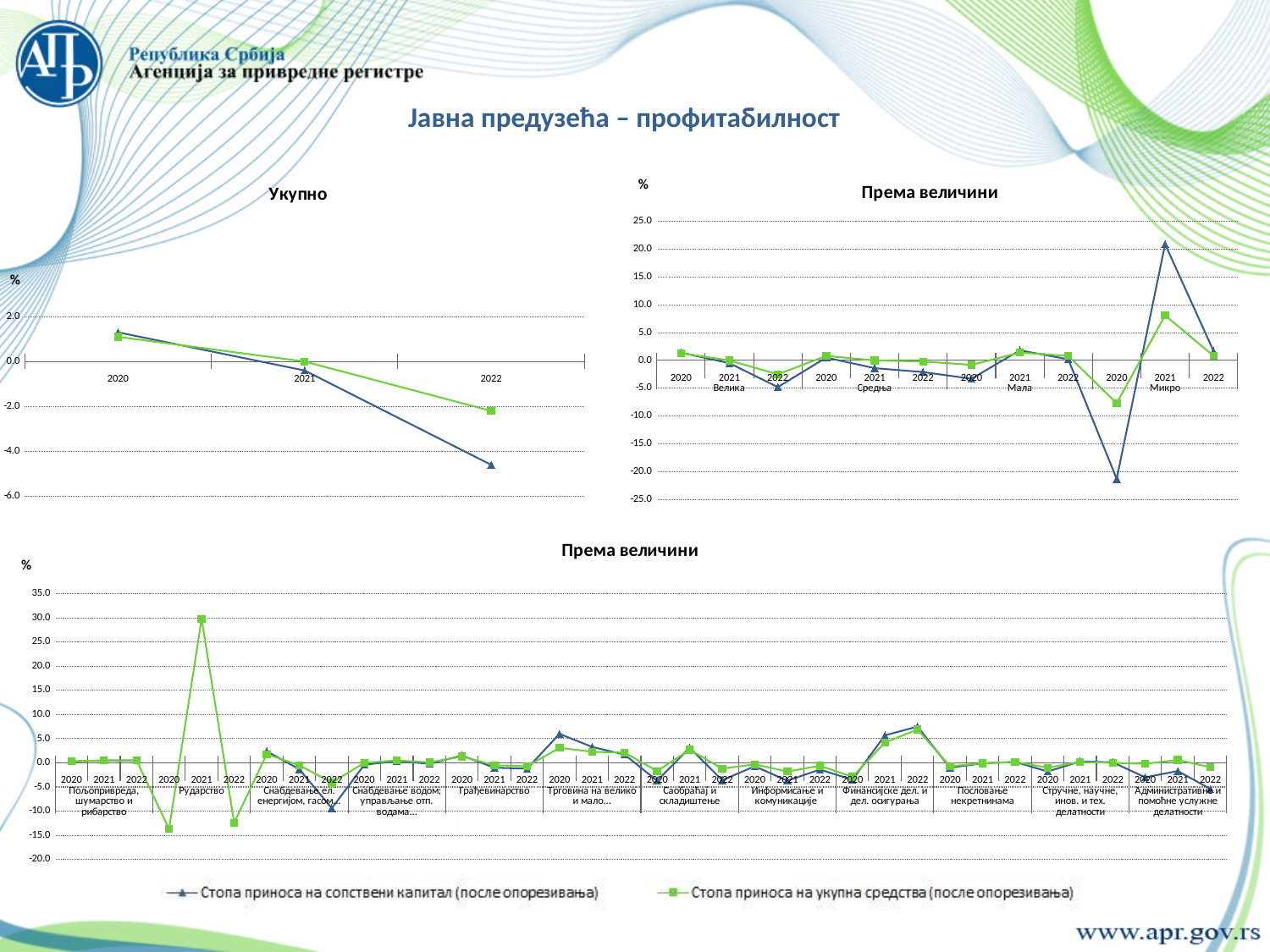
In the 'Укупно' chart, is the 2022 value for 'Стопа приноса на сопствени капитал (после опорезивања)' greater or less than -4.0? less What type of chart is the 'Укупно' chart at the top left of the slide? line chart In the top-right 'Према величини' chart, how many size groups are shown on the x axis? 4 In the 'Укупно' chart, is the 2020 value for 'Стопа приноса на укупна средства (после опорезивања)' greater or less than 0.0? greater In the bottom chart, is the 2021 value for 'Рударство' for 'Стопа приноса на укупна средства (после опорезивања)' greater or less than 25.0? greater In the 'Укупно' chart, how many years are plotted along the x axis? 3 In the bottom chart, how many activity sectors are shown on the x axis? 12 How many series does the legend at the bottom of the slide list? 2 What is the title of the slide? Јавна предузећа – профитабилност In the top-right 'Према величини' chart, which size group and year has the highest value for 'Стопа приноса на сопствени капитал (после опорезивања)'? Микро, 2021 In the 'Укупно' chart, do the values rise or fall from 2020 to 2022? fall